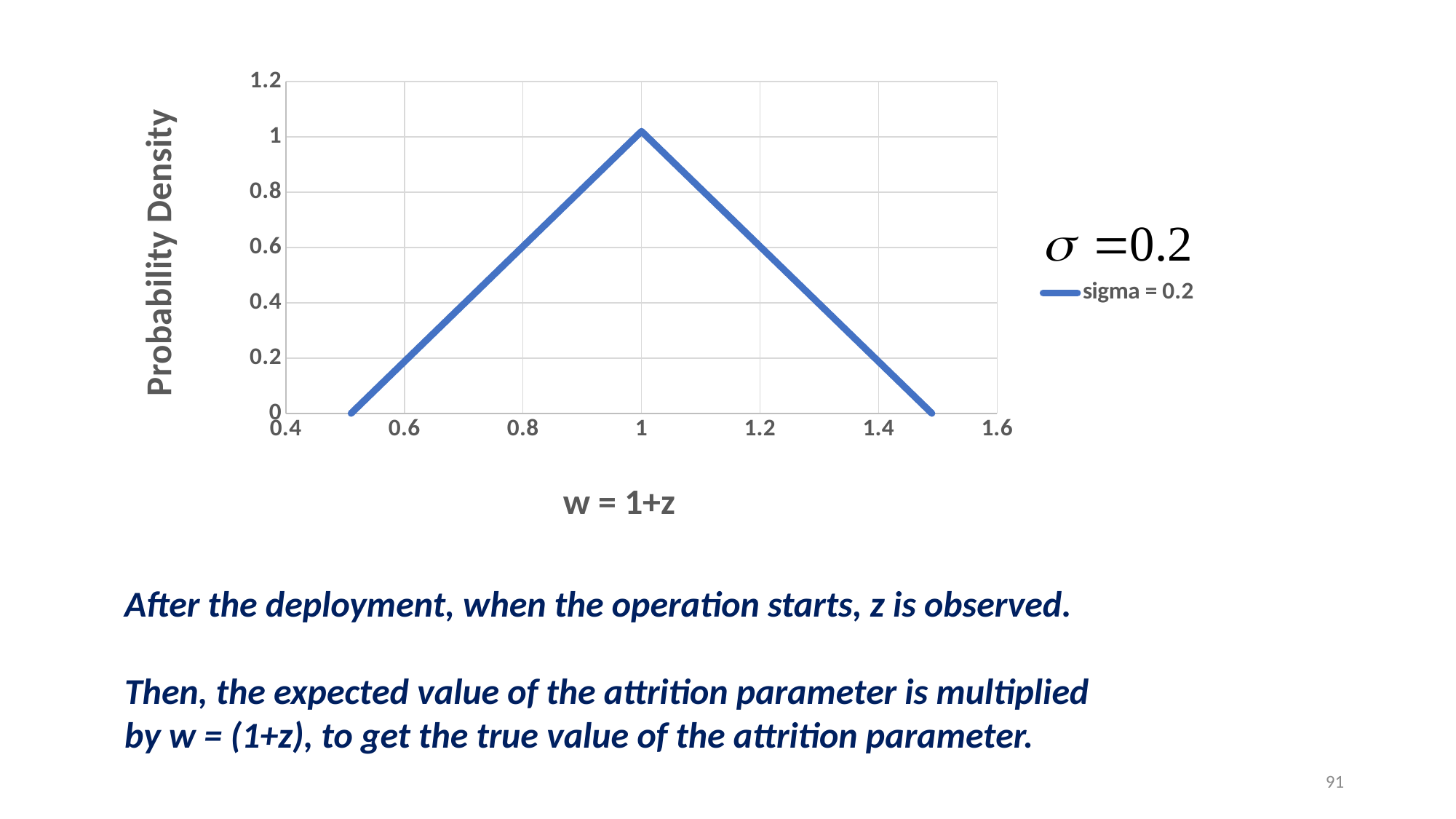
What kind of chart is shown on the slide? line chart Does the probability density rise or fall as w increases from 1 to 1.4? fall Is the probability density at w = 1.2 greater or less than 0.8? less What is the title of the vertical axis? Probability Density Is the probability density at w = 0.8 greater or less than 0.4? greater Is the probability density at w = 0.6 greater or less than 0.4? less Which has the higher probability density: w = 0.8 or w = 1? w = 1 Does the probability density rise or fall as w increases from 0.6 to 1? rise How many series does the legend list? 1 At which value of w does the probability density reach its maximum? 1 What is the legend entry for the plotted series? sigma = 0.2